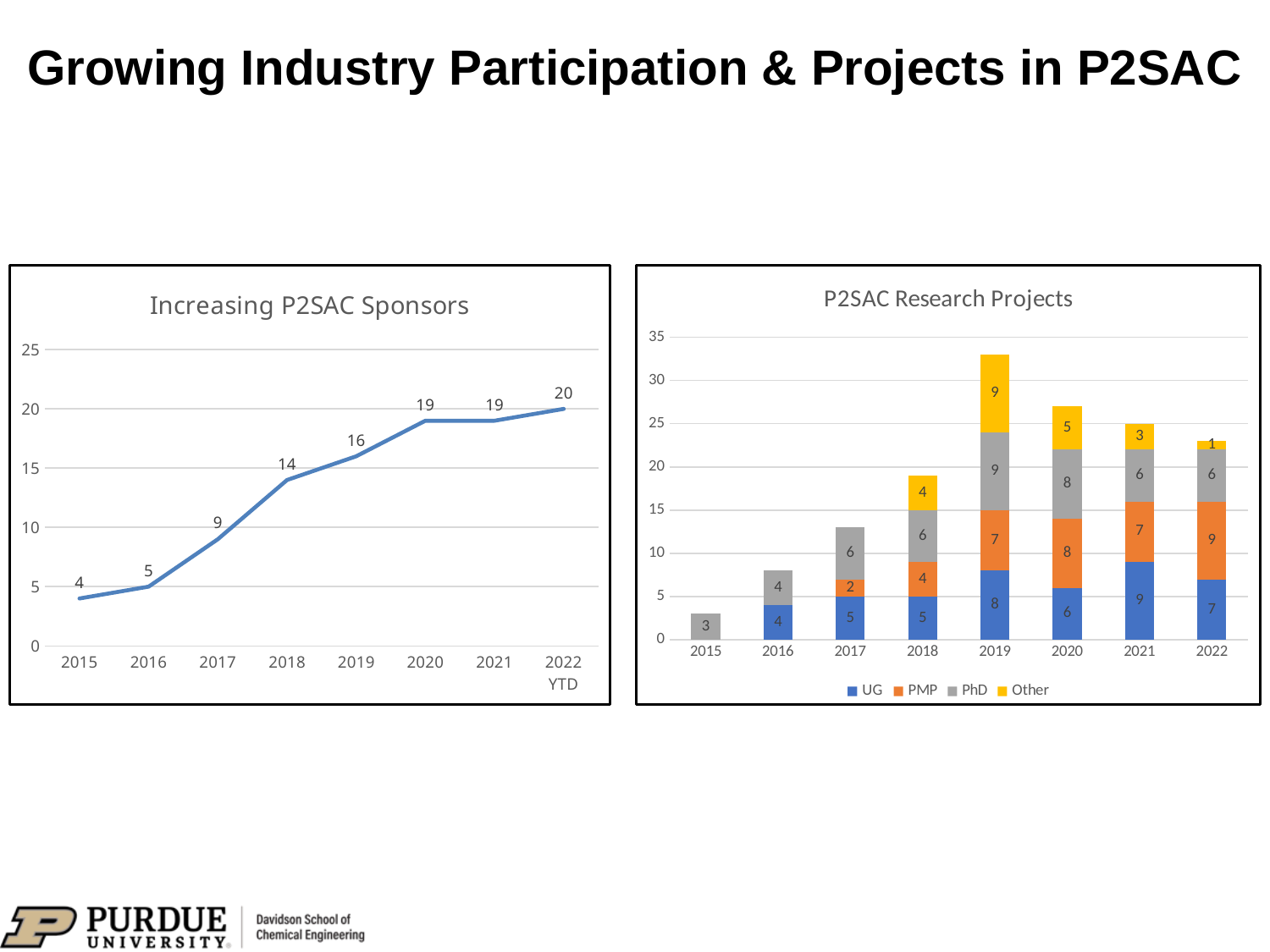
In the "P2SAC Research Projects" chart, what is the PMP value for 2020? 8 In the "P2SAC Research Projects" chart, how many series does the legend list? 4 In the "Increasing P2SAC Sponsors" chart, what is the value for 2018? 14 What kind of chart is "P2SAC Research Projects"? stacked bar chart In the "Increasing P2SAC Sponsors" chart, which year has the lowest number of sponsors? 2015 In the "Increasing P2SAC Sponsors" chart, how many data points are plotted? 8 In the "Increasing P2SAC Sponsors" chart, do the values generally rise or fall from 2015 to 2022 YTD? rise What kind of chart is "Increasing P2SAC Sponsors"? line chart In the "P2SAC Research Projects" chart, what is the total of the stacked bar for 2019? 33 In the "P2SAC Research Projects" chart, which year has the tallest stacked bar? 2019 In the "Increasing P2SAC Sponsors" chart, what is the difference between the values for 2019 and 2017? 7 In the "P2SAC Research Projects" chart, which is larger: the UG value for 2021 or the UG value for 2022? 2021